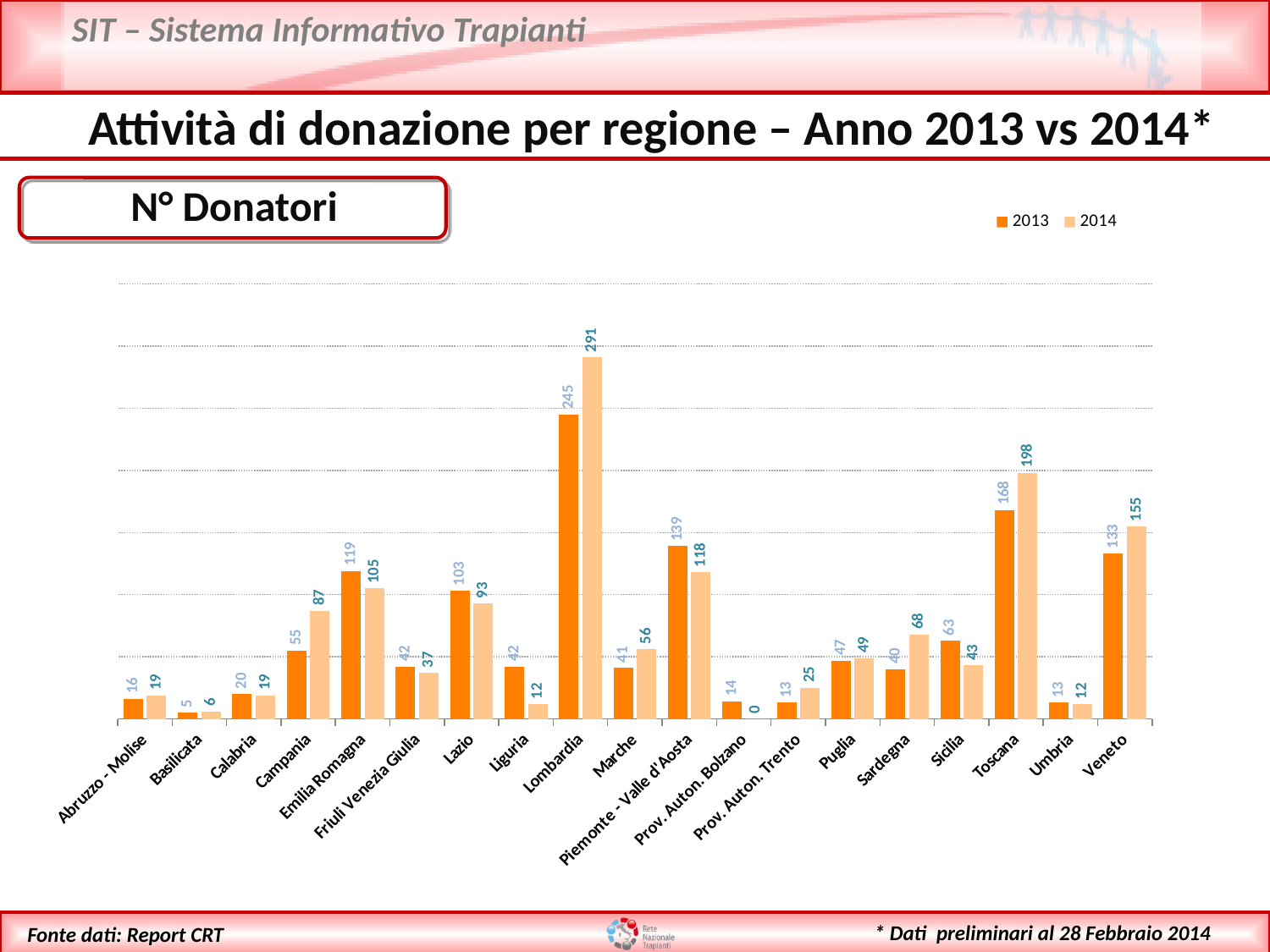
How many regions are shown on the x axis? 19 Which region has the lowest 2013 value? Basilicata What kind of chart is shown on the slide? Bar chart What is the difference between the 2013 and 2014 values for Liguria? 30 Which is larger for Emilia Romagna, the 2013 value or the 2014 value? 2013 Which is larger for Veneto, the 2013 value or the 2014 value? 2014 What is the 2013 value for Toscana? 168 Which region has the highest 2013 value? Lombardia What is the 2014 value for Prov. Auton. Bolzano? 0 What is the 2014 value for Lombardia? 291 What is the difference between the 2014 and 2013 values for Campania? 32 How many series does the legend list? 2